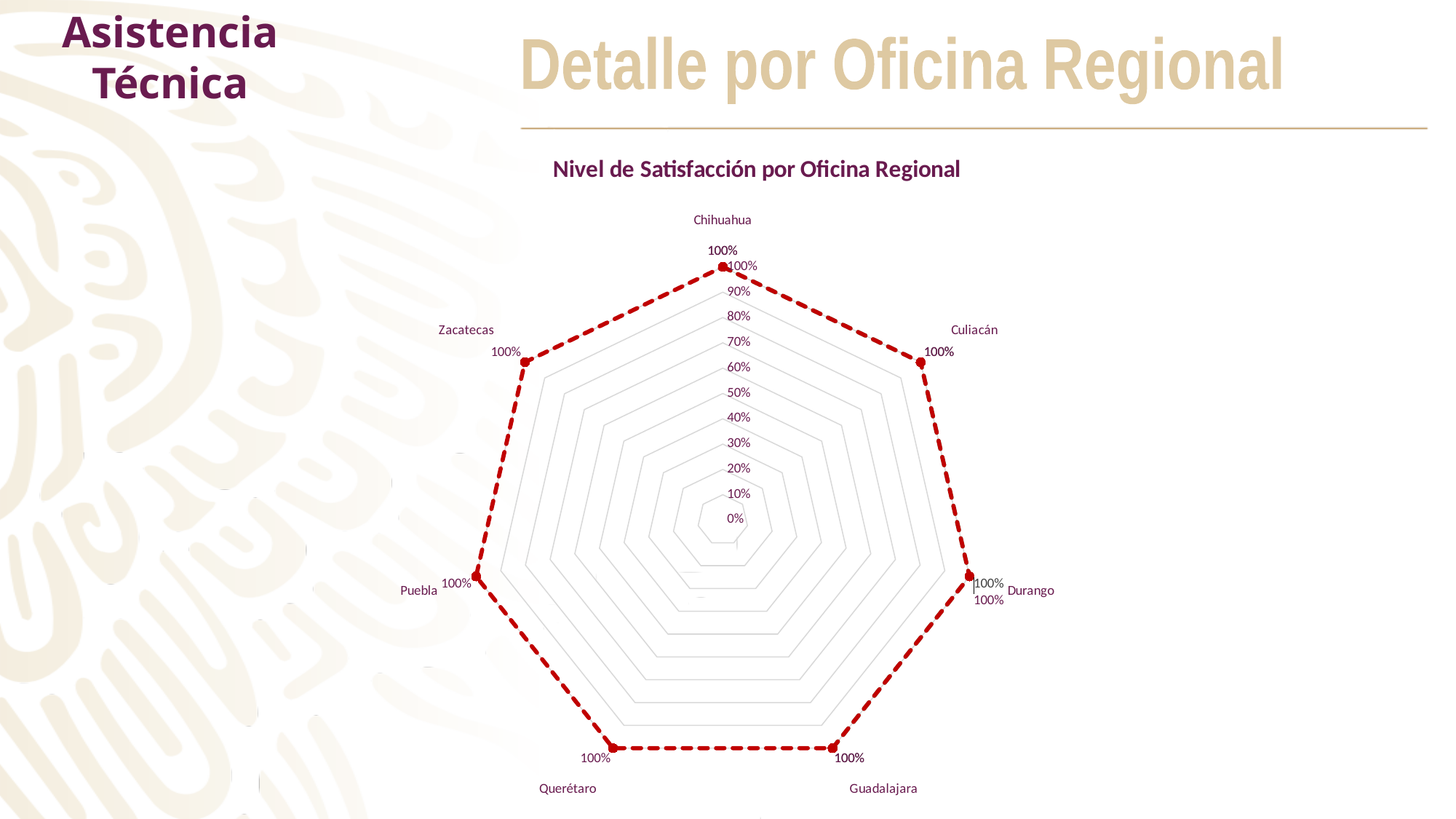
What is the satisfaction level for Durango? 100% What is the title of the chart? Nivel de Satisfacción por Oficina Regional What is the satisfaction level for Zacatecas? 100% Is the value for Zacatecas greater or less than 50%? greater What is the satisfaction level for Puebla? 100% What is the satisfaction level for Chihuahua? 100% What is the difference between the satisfaction levels of Puebla and Guadalajara? 0% What is the satisfaction level for Culiacán? 100% What kind of chart is shown on the slide? Radar chart How many regional offices are plotted on the chart? 7 What is the satisfaction level for Querétaro? 100% What is the satisfaction level for Guadalajara? 100%